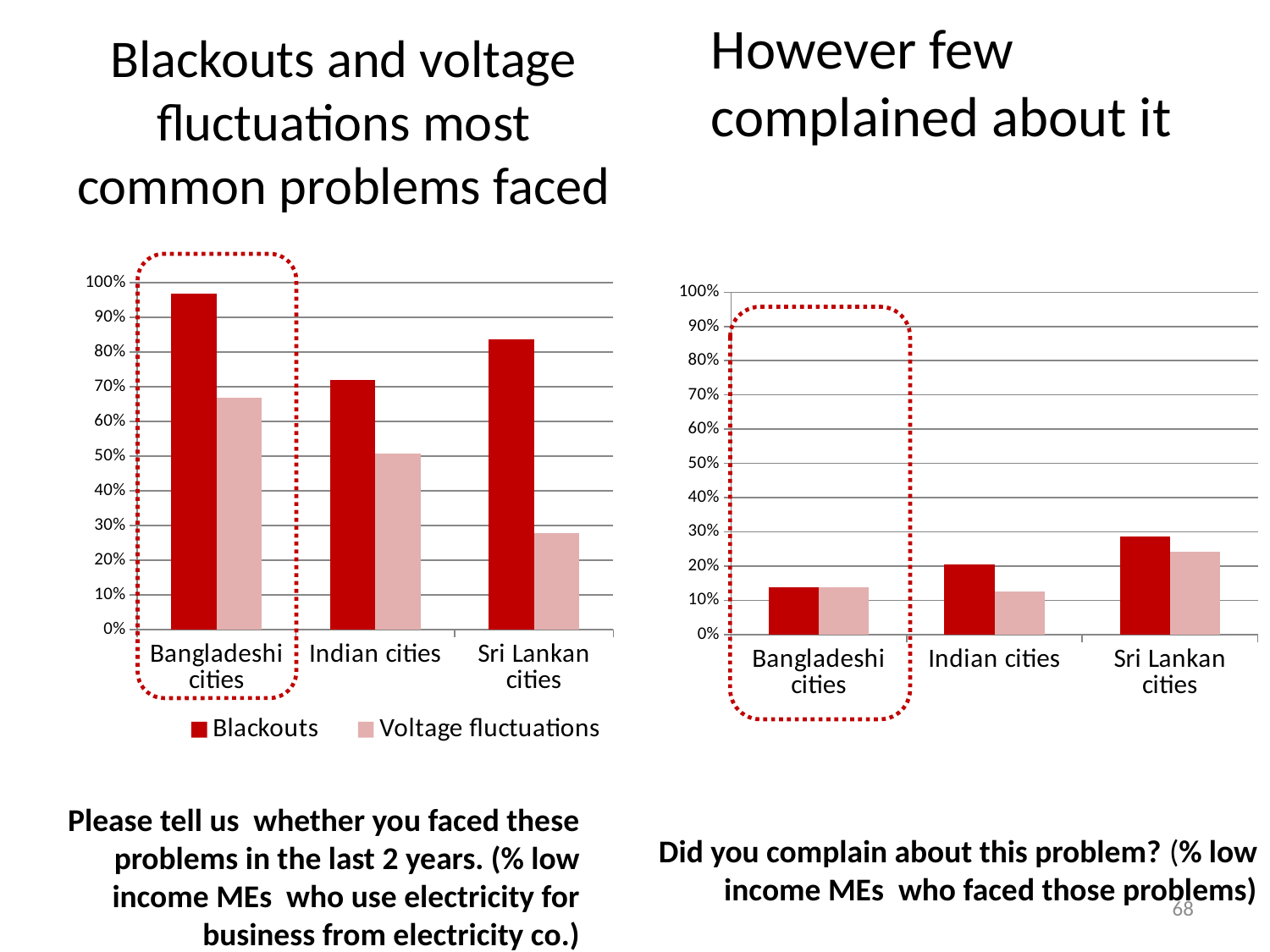
In the left chart, which category has the highest Blackouts value? Bangladeshi cities In the right chart titled 'However few complained about it', is the dark red bar for Bangladeshi cities greater or less than 20%? less What kind of chart is the left chart titled 'Blackouts and voltage fluctuations most common problems faced'? bar chart In the left chart, which category has the lowest Voltage fluctuations value? Sri Lankan cities In the right chart titled 'However few complained about it', is the dark red bar for Sri Lankan cities greater or less than 20%? greater How many city categories are shown on the x axis of the left chart? 3 What are the two legend entries of the left chart? Blackouts and Voltage fluctuations In the right chart titled 'However few complained about it', which category has the highest dark red bar? Sri Lankan cities In the left chart, is the Blackouts value for Bangladeshi cities greater or less than 90%? greater In the left chart, which is larger for Indian cities: Blackouts or Voltage fluctuations? Blackouts How many series does the legend of the left chart list? 2